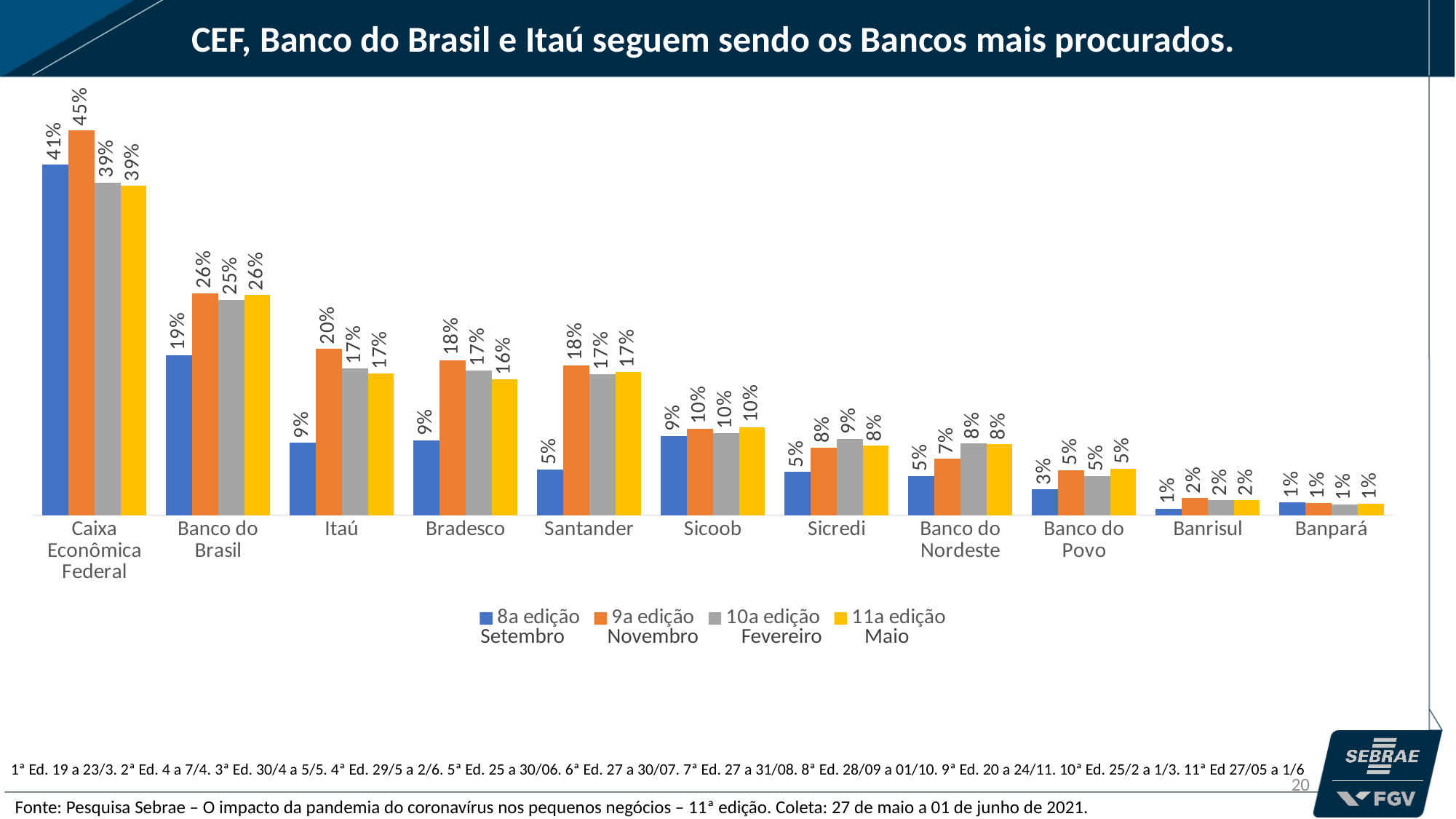
What is the value for Banco do Brasil in the 8a edição (Setembro) series? 19% What is the value for Itaú in the 11a edição (Maio) series? 17% What is the value for Sicredi in the 10a edição (Fevereiro) series? 9% How many banks are shown on the x axis? 11 Which is larger for Santander: the 8a edição value or the 9a edição value? 9a edição What kind of chart is shown on the slide? Bar chart What is the difference between the 9a edição and 8a edição values for Caixa Econômica Federal? 4% How many series does the legend list? 4 Which colour represents the 11a edição (Maio) series? Yellow Which bank has the highest value in the 11a edição (Maio) series? Caixa Econômica Federal Which bank has the lowest value in the 9a edição (Novembro) series? Banpará What is the value for Caixa Econômica Federal in the 9a edição (Novembro) series? 45%